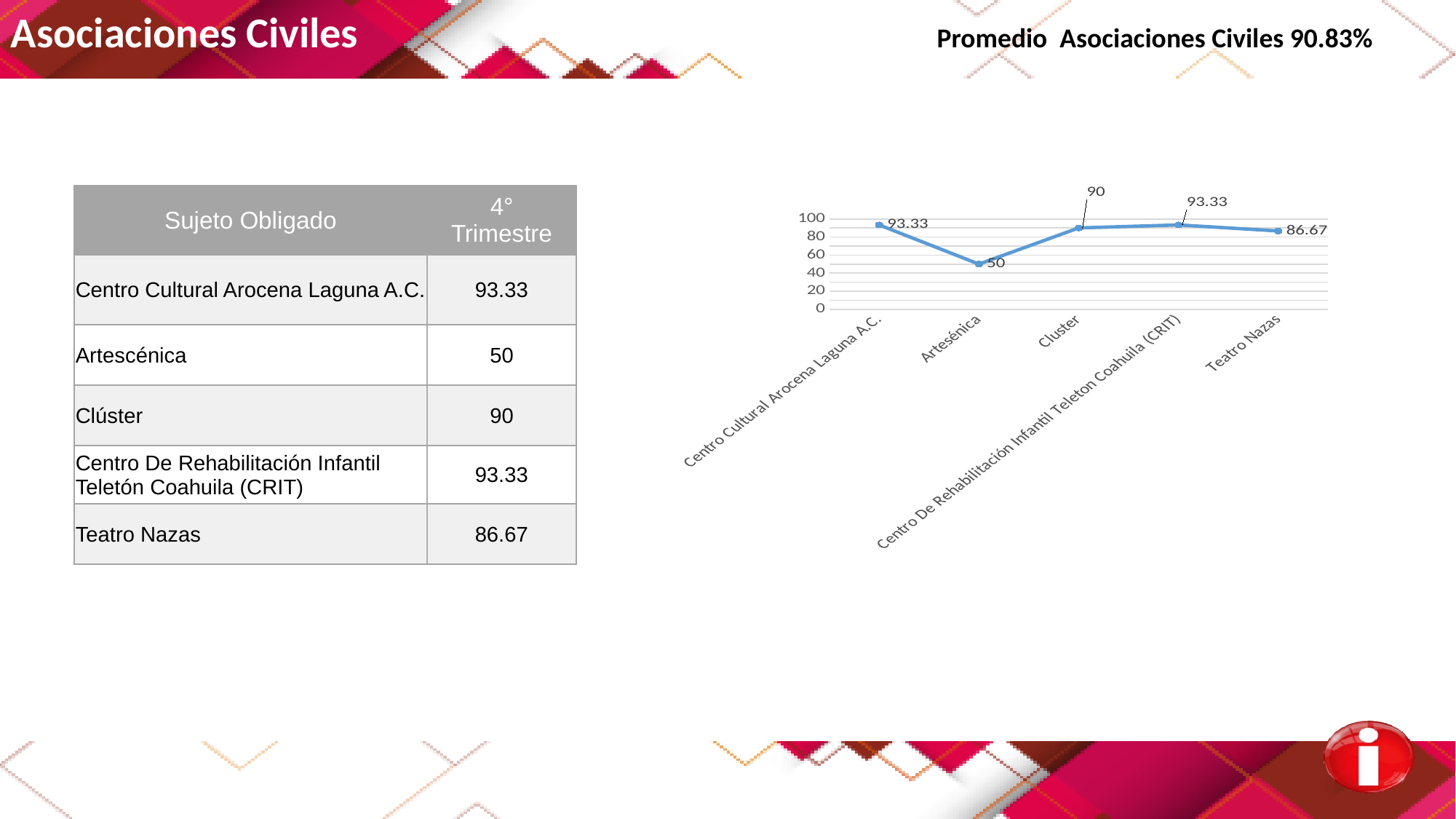
Is the value for Artesénica greater or less than 60? less What is the difference between the values for Centro De Rehabilitación Infantil Teleton Coahuila (CRIT) and Teatro Nazas? 6.66 What is the value for Artesénica on the chart? 50 Does the line rise or fall from Artesénica to Cluster? rise What kind of chart is shown on the slide? line chart Which has a larger value, Cluster or Teatro Nazas? Cluster How many categories are plotted on the chart? 5 What is the value for Teatro Nazas on the chart? 86.67 What is the difference between the values for Cluster and Artesénica? 40 Which category has the lowest value on the chart? Artesénica What is the value for Centro Cultural Arocena Laguna A.C. on the chart? 93.33 What is the value for Cluster on the chart? 90